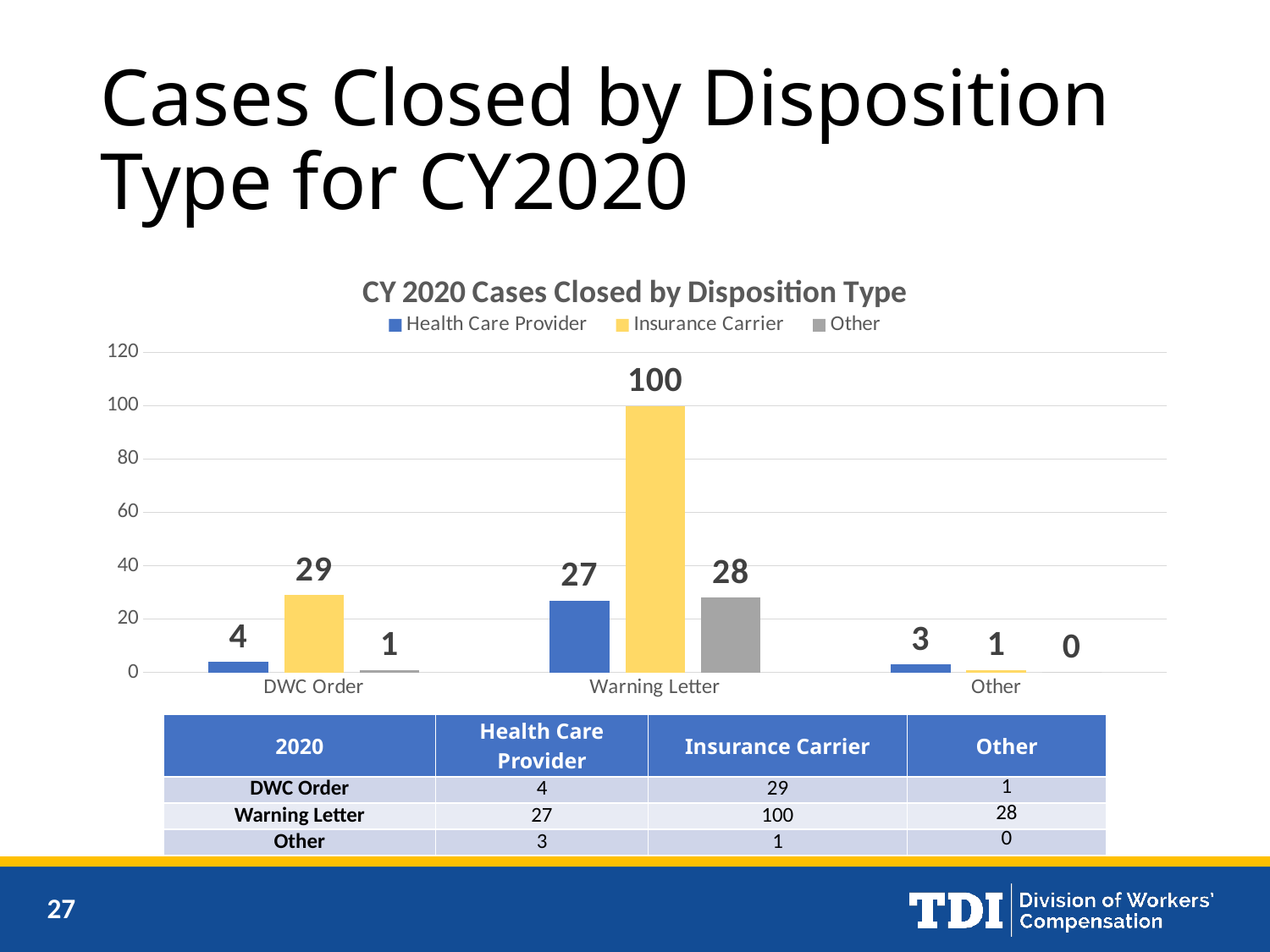
Which is larger in the DWC Order category: Health Care Provider or Insurance Carrier? Insurance Carrier How many categories are shown on the x axis? 3 What is the title of the chart? CY 2020 Cases Closed by Disposition Type What is the difference between the Insurance Carrier and Health Care Provider values in the Warning Letter category? 73 How many series does the legend list? 3 What kind of chart is shown? bar chart What is the value for Insurance Carrier in the Warning Letter category? 100 Which category has the highest Insurance Carrier value? Warning Letter What is the value for Other in the Other category? 0 What is the value for Health Care Provider in the DWC Order category? 4 Is the value for Insurance Carrier in the Warning Letter category greater or less than 80? greater Which category has the lowest Health Care Provider value? Other